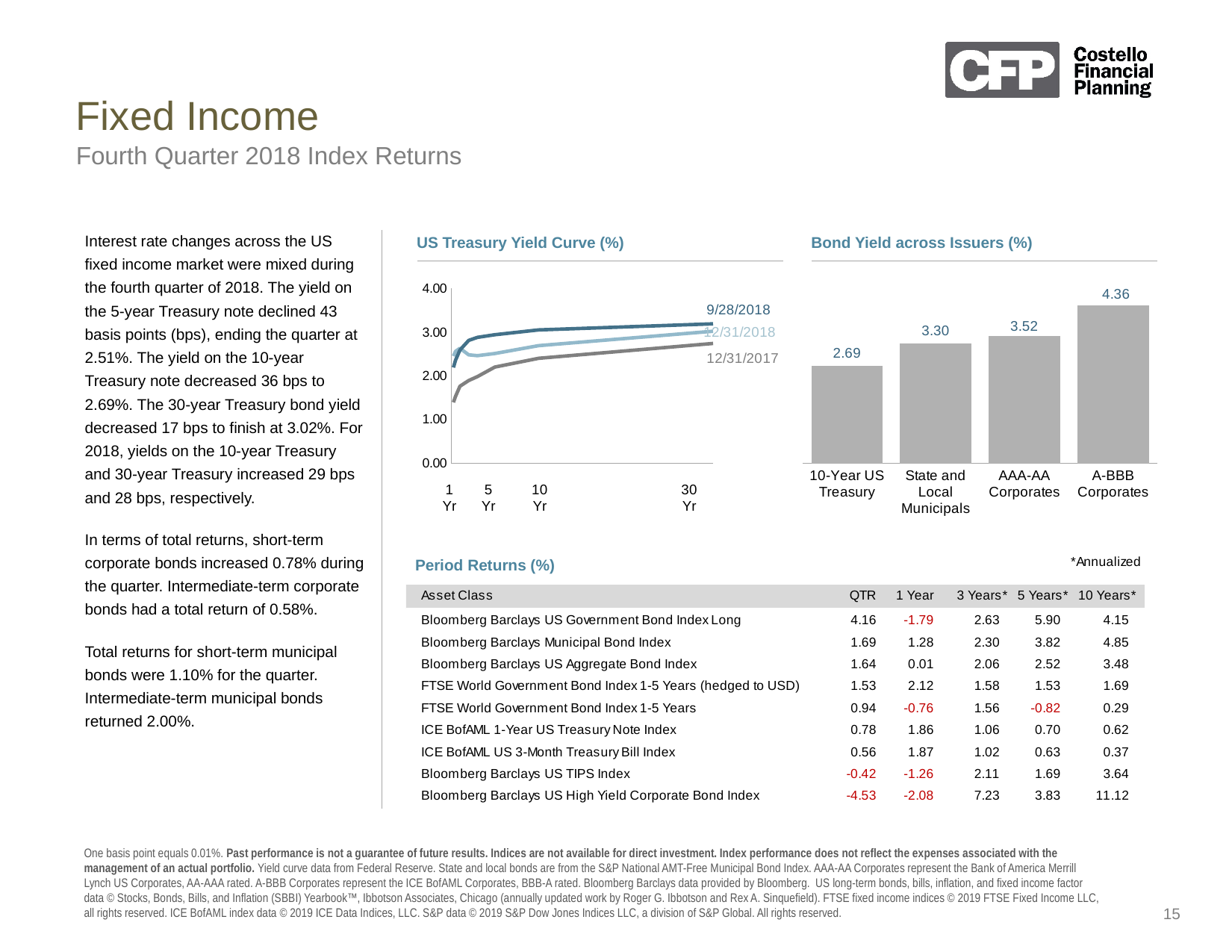
In the 'Bond Yield across Issuers (%)' chart, which category has the lowest value? 10-Year US Treasury What kind of chart is 'Bond Yield across Issuers (%)'? Bar chart In the 'Bond Yield across Issuers (%)' chart, which is larger: State and Local Municipals or AAA-AA Corporates? AAA-AA Corporates What kind of chart is 'US Treasury Yield Curve (%)'? Line chart In the 'Bond Yield across Issuers (%)' chart, what is the value for 10-Year US Treasury? 2.69 In the 'US Treasury Yield Curve (%)' chart, do the yields generally rise or fall from 1 Yr to 30 Yr? Rise How many series are plotted in the 'US Treasury Yield Curve (%)' chart? 3 In the 'Bond Yield across Issuers (%)' chart, what is the difference between A-BBB Corporates and State and Local Municipals? 1.06 How many categories are shown in the 'Bond Yield across Issuers (%)' chart? 4 In the 'Bond Yield across Issuers (%)' chart, which category has the highest value? A-BBB Corporates In the 'US Treasury Yield Curve (%)' chart, is the 12/31/2017 value at 1 Yr greater or less than 2.00? less In the 'Bond Yield across Issuers (%)' chart, what is the value for AAA-AA Corporates? 3.52